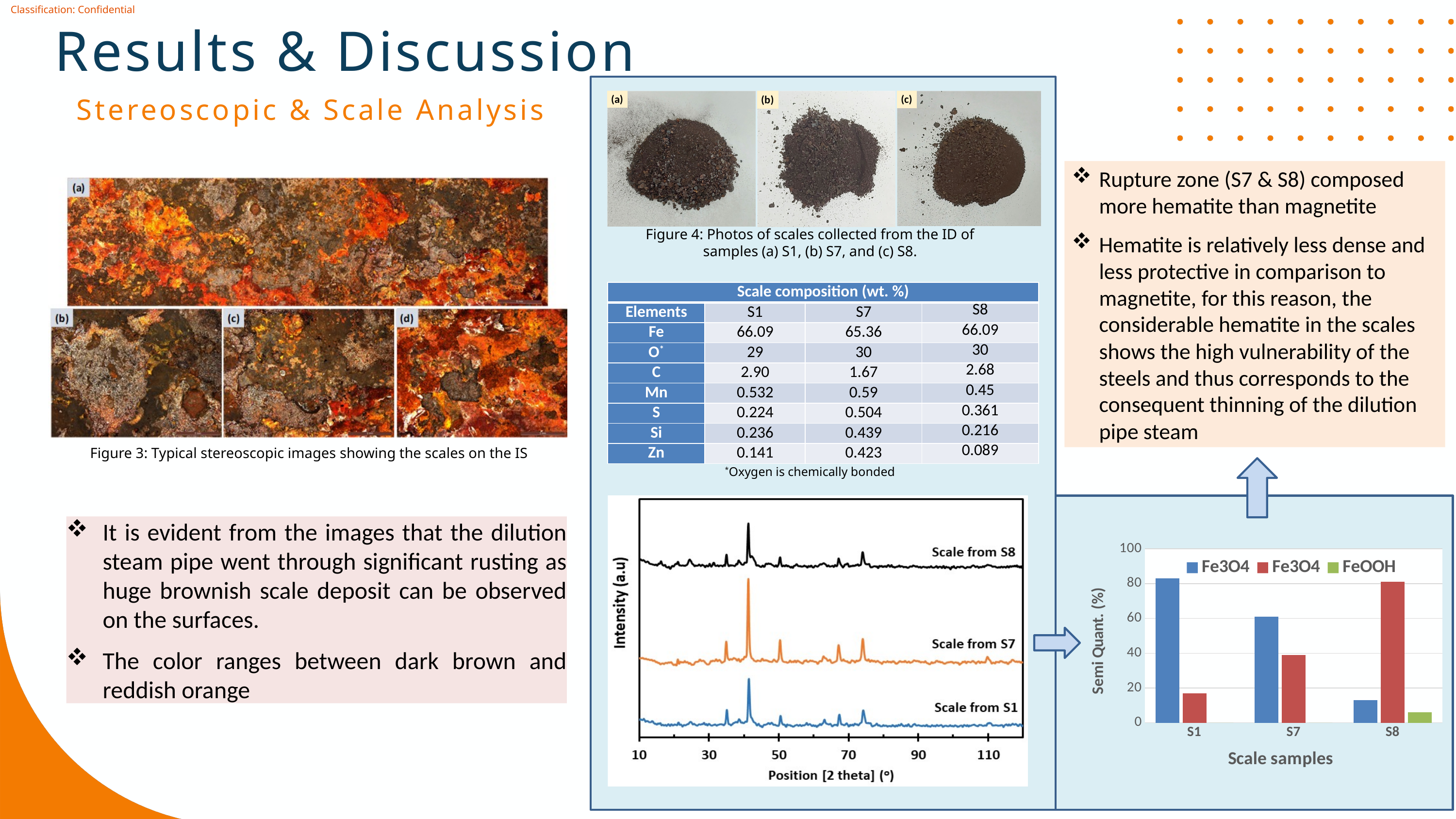
In the bar chart at the bottom right, is the blue bar for S1 greater or less than 80? greater In the bar chart at the bottom right, for S8, which is larger, the blue bar or the red bar? the red bar In the bar chart at the bottom right, how many series does the legend list? 3 In the bar chart at the bottom right, which scale sample has the lowest blue bar? S8 In the bar chart at the bottom right, how many scale samples are shown on the x axis? 3 In the bar chart at the bottom right, what is the label of the x axis? Scale samples In the bar chart at the bottom right, what is the label of the y axis? Semi Quant. (%) In the bar chart at the bottom right, is the red bar for S1 greater or less than 20? less In the bar chart at the bottom right, what kind of chart is it? bar chart In the bar chart at the bottom right, which scale sample has the highest blue bar? S1